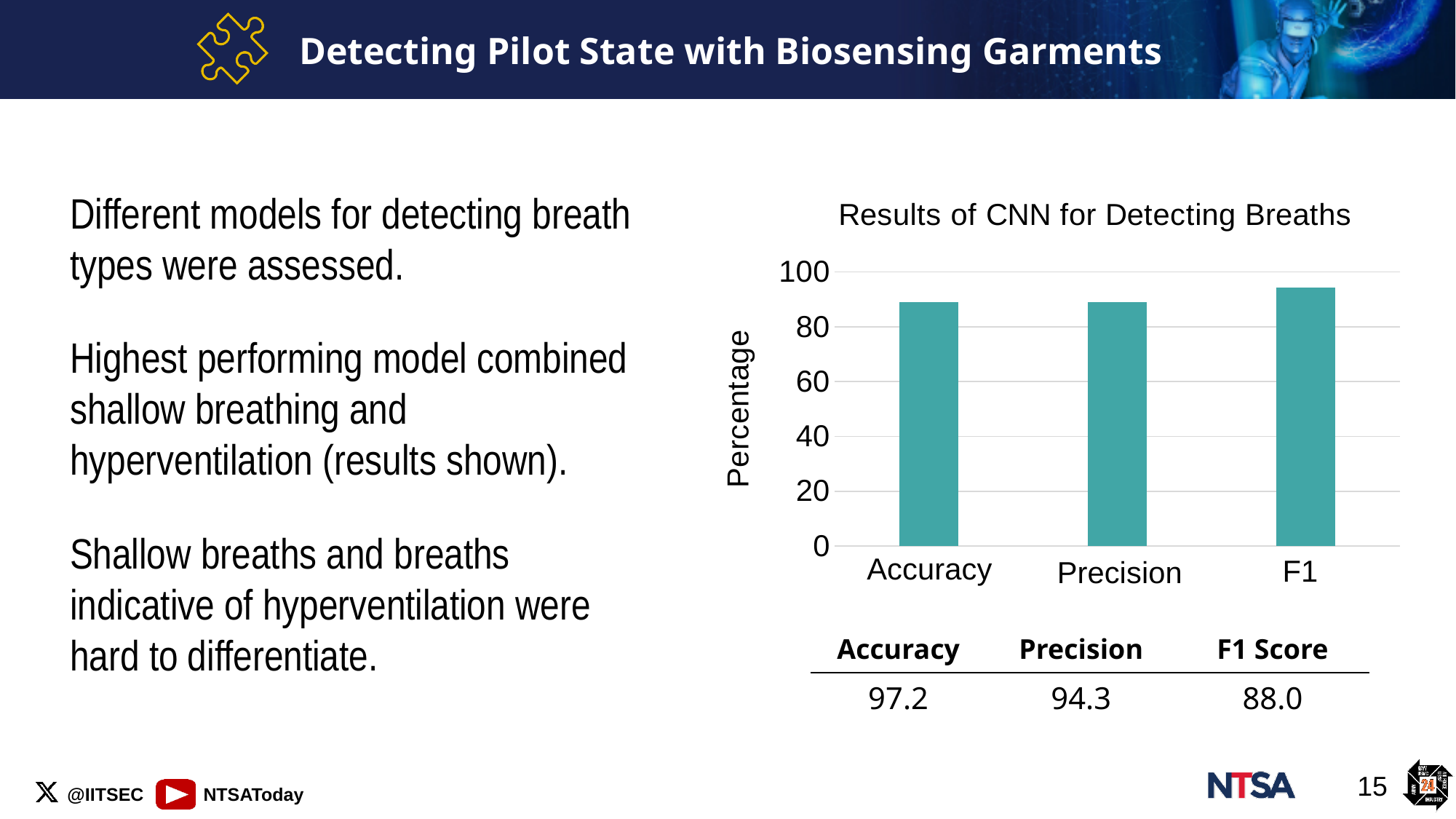
Is the value for Accuracy greater or less than 100? less Is the value for Accuracy greater or less than 80? greater How many categories are plotted in the chart? 3 Is the value for F1 greater or less than 80? greater What is the title of the chart? Results of CNN for Detecting Breaths What kind of chart is shown on the slide? bar chart What is the highest tick value shown on the vertical axis of the chart? 100 What is the label on the vertical axis of the chart? Percentage